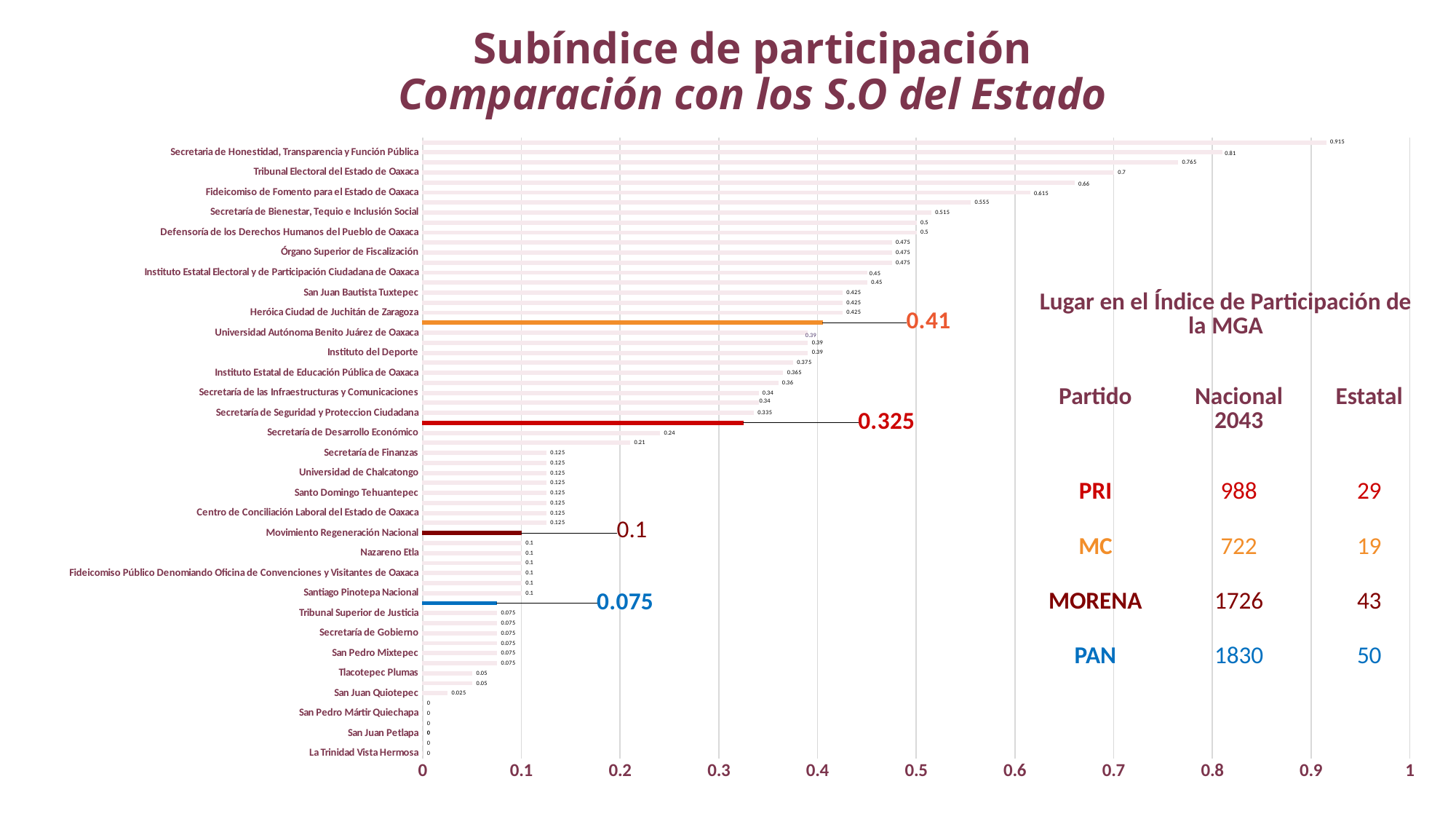
What is the value for Movimiento Regeneración Nacional? 0.1 What is the highest value shown in the chart? 0.915 What is the difference between the orange highlighted bar (0.41) and the red highlighted bar (0.325)? 0.085 What is the maximum value shown on the horizontal axis? 1 Do the bar values increase or decrease going from the top of the chart to the bottom? decrease What is the lowest value shown in the chart? 0 What kind of chart is shown on the slide? bar chart What is the value of the blue highlighted bar in the chart? 0.075 Which is larger, the orange highlighted bar or the blue highlighted bar? the orange bar (0.41) Is the value of the longest bar greater or less than 0.9? greater What is the value of the red highlighted bar in the chart? 0.325 What is the value of the orange highlighted bar in the chart? 0.41